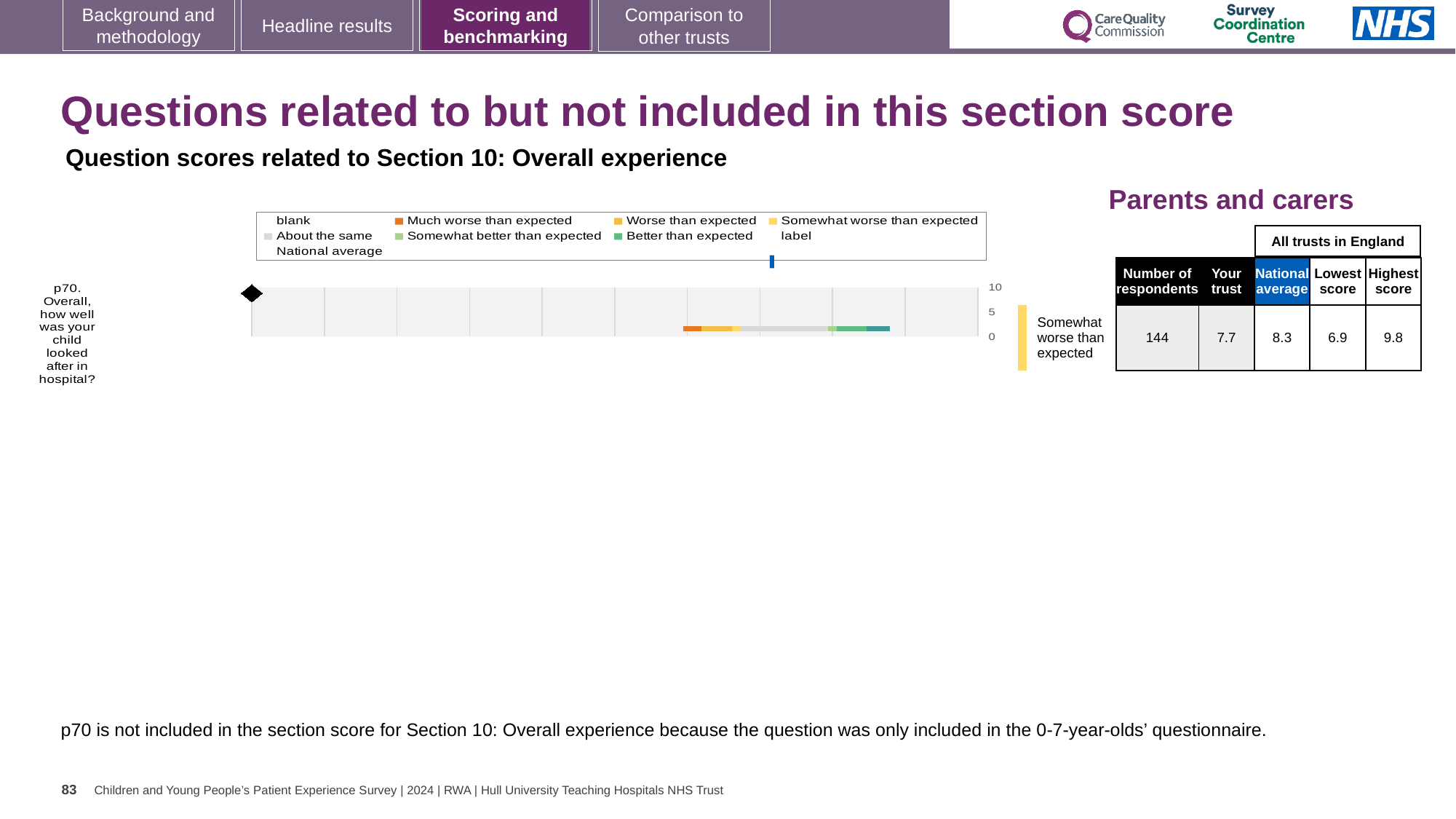
What is the highest score among all trusts in England for p70? 9.8 What is the lowest score among all trusts in England for p70? 6.9 Is the trust's score for p70 higher or lower than the national average? lower How many respondents answered p70? 144 What is the highest value shown on the chart's axis? 10 How many questions are plotted in the chart? 1 What is the difference between the national average and the trust's score for p70? 0.6 What is the national average score for p70? 8.3 What is the 'Your trust' score for p70? 7.7 What kind of chart is shown on the slide? bar chart Which question is plotted in the chart? p70. Overall, how well was your child looked after in hospital? What is the difference between the highest and lowest scores among all trusts in England for p70? 2.9